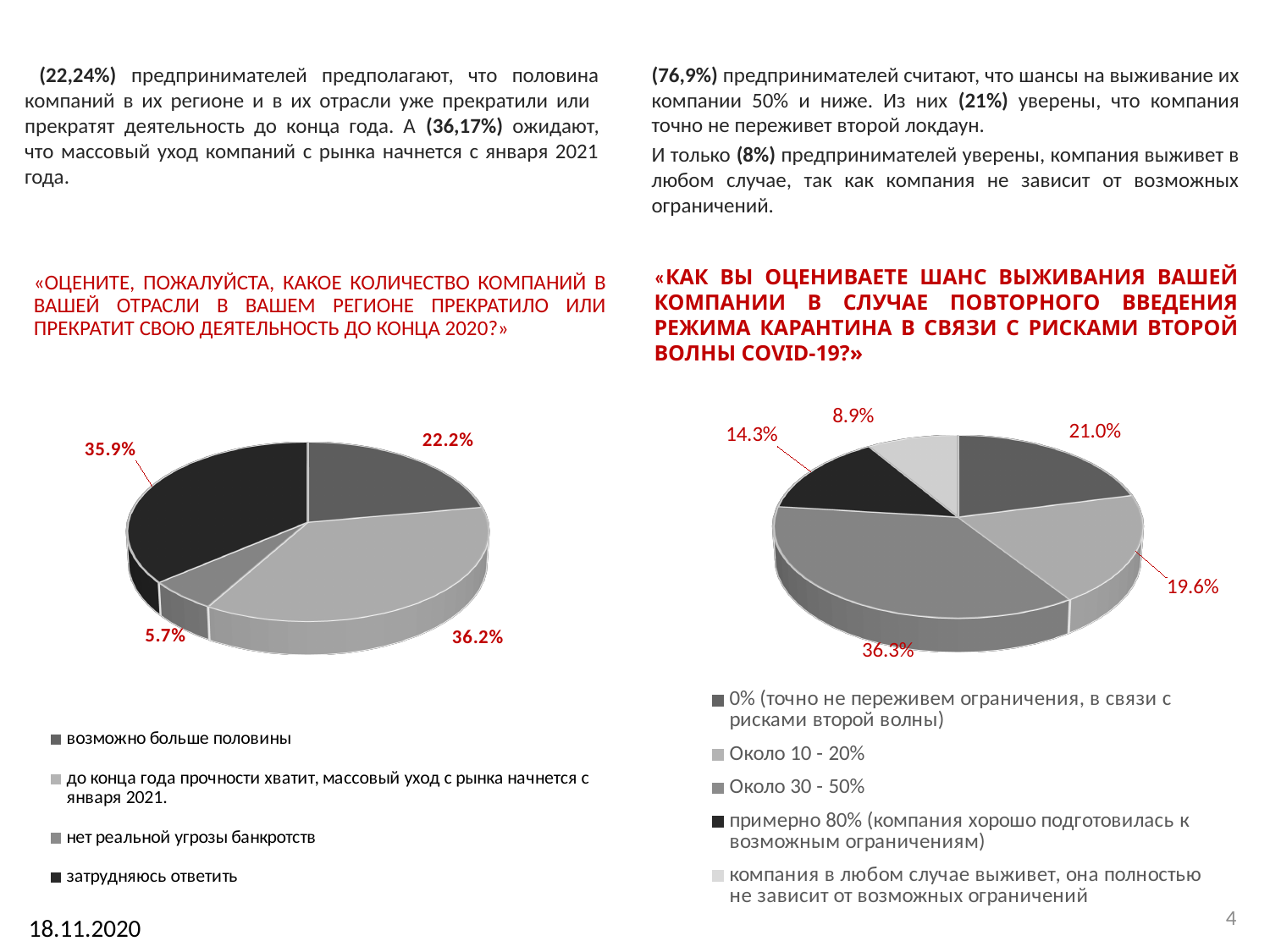
In the right pie chart, which is larger: the slice for 'Около 10 - 20%' or the slice for 'примерно 80% (компания хорошо подготовилась к возможным ограничениям)'? Около 10 - 20% In the left pie chart, which slice is the smallest? нет реальной угрозы банкротств In the right pie chart, which slice is the smallest? компания в любом случае выживет, она полностью не зависит от возможных ограничений In the left pie chart, which slice is the largest? до конца года прочности хватит, массовый уход с рынка начнется с января 2021. In the left pie chart, what share is labelled for the slice 'нет реальной угрозы банкротств'? 5.7% What type of chart is shown on the right side of the slide? Pie chart In the left pie chart, what share is labelled for the slice 'возможно больше половины'? 22.2% In the left pie chart, what is the difference between the 22.2% slice and the 5.7% slice? 16.5% How many slices does the left pie chart have? 4 In the right pie chart, what share is labelled for 'компания в любом случае выживет, она полностью не зависит от возможных ограничений'? 8.9% In the right pie chart, what share is labelled for 'Около 30 - 50%'? 36.3% How many entries does the legend of the right pie chart list? 5